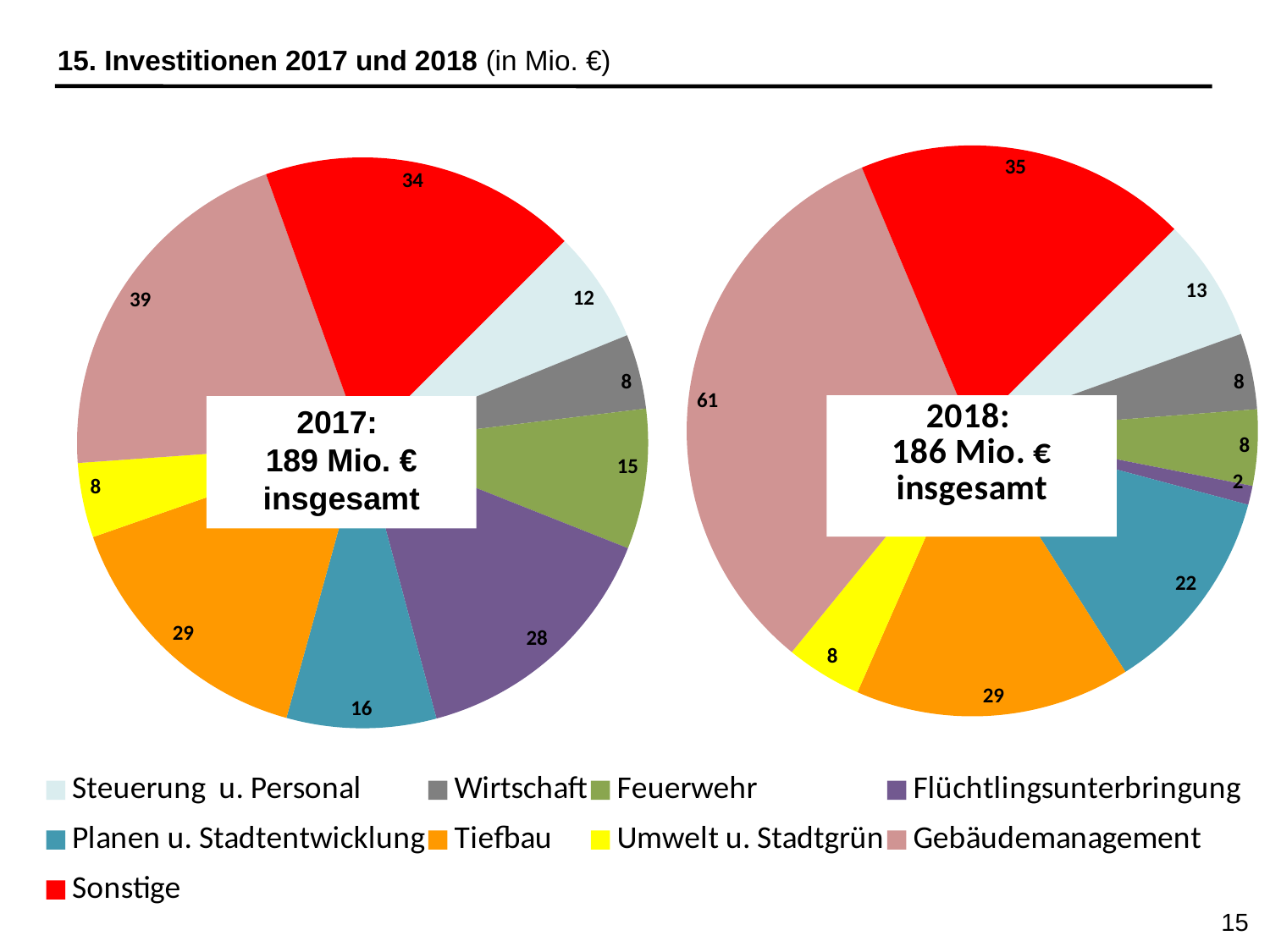
What is the difference between the Gebäudemanagement values in the 2018 and 2017 pie charts? 22 In the 2018 pie chart, which category has the smallest value? Flüchtlingsunterbringung In the 2017 pie chart, what is the value for Gebäudemanagement? 39 In the 2018 pie chart, what is the value for Flüchtlingsunterbringung? 2 In the 2017 pie chart, which category has the largest value? Gebäudemanagement In the 2018 pie chart, which category has the largest value? Gebäudemanagement What is the total shown for the 2017 pie chart? 189 Mio. € In the 2018 pie chart, what is the value for Planen u. Stadtentwicklung? 22 What type of charts are shown on the slide? Pie charts In the 2017 pie chart, which is larger: Tiefbau or Flüchtlingsunterbringung? Tiefbau How many categories does the legend list? 9 What colour represents Sonstige in the pie charts? Red